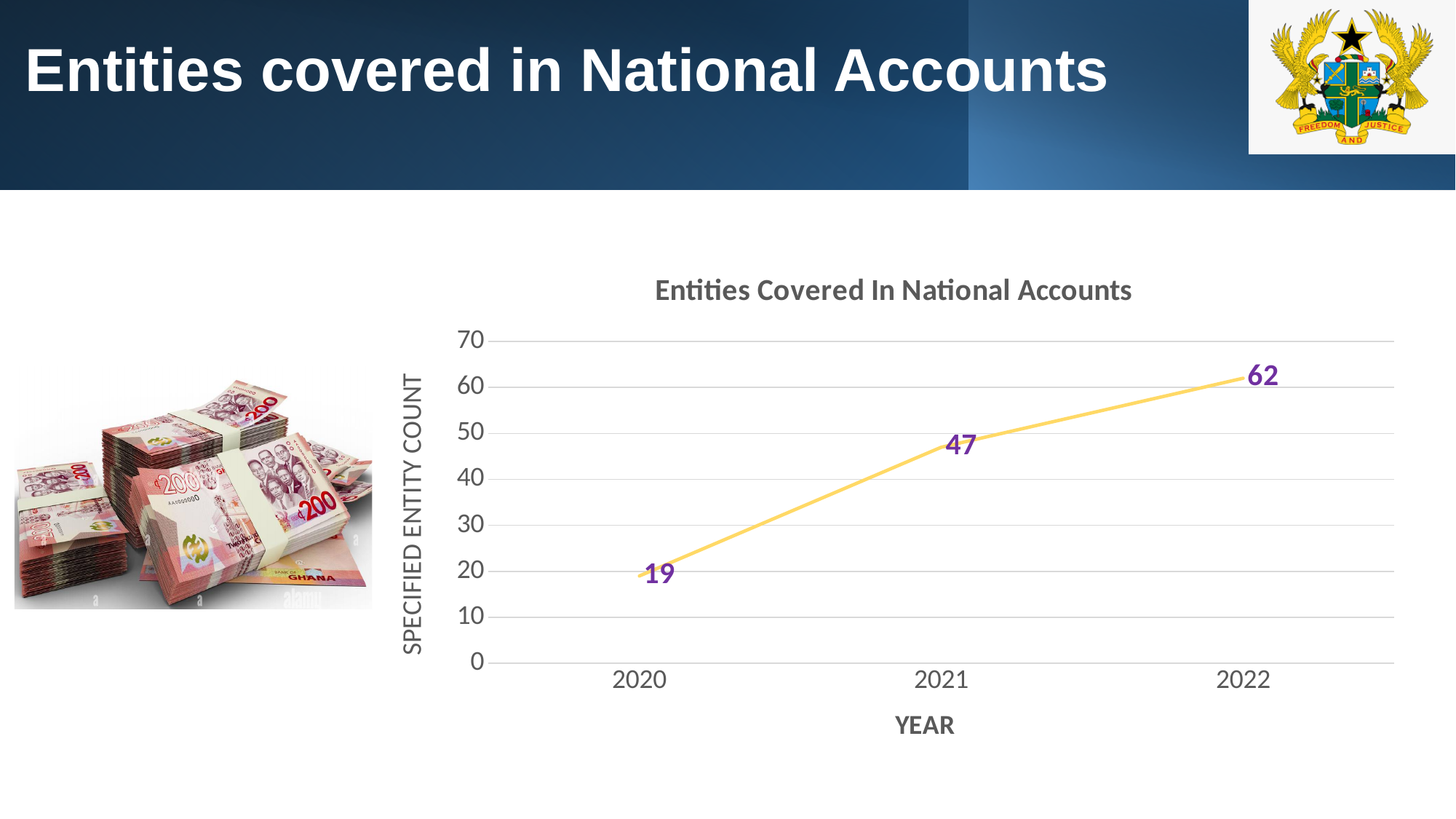
What is the specified entity count for 2020? 19 Is the value for 2022 greater or less than 60? greater Which year has a larger entity count, 2020 or 2021? 2021 Which year has the highest specified entity count? 2022 Which year has the lowest specified entity count? 2020 What is the difference between the entity counts for 2021 and 2020? 28 How many years are plotted on the chart? 3 What is the difference between the entity counts for 2022 and 2021? 15 Do the values rise or fall from 2020 to 2022? Rise What is the specified entity count for 2021? 47 What kind of chart is shown on the slide? Line chart What is the specified entity count for 2022? 62